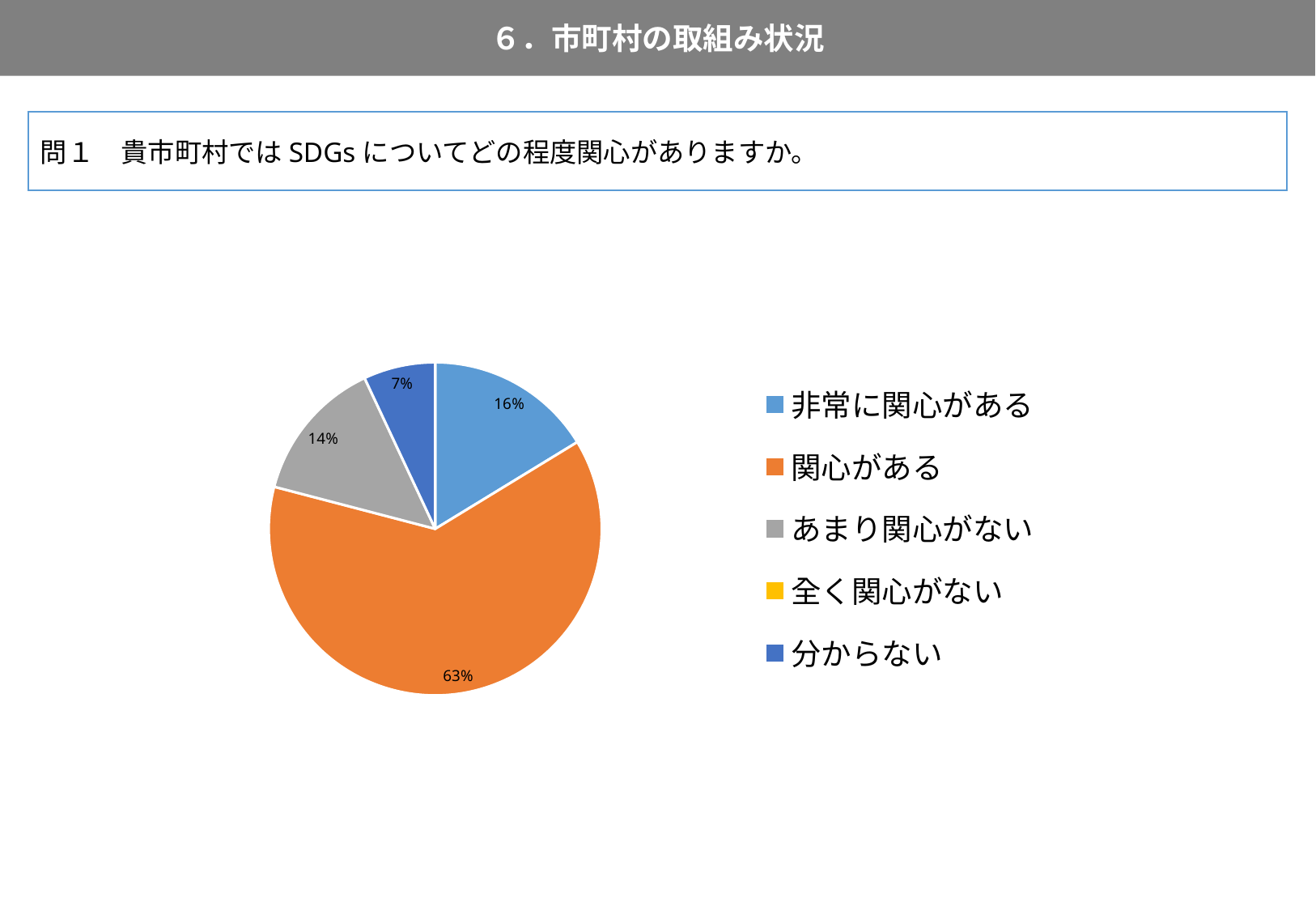
What colour is the slice for 関心がある? orange Which is larger, the share for 非常に関心がある or the share for あまり関心がない? 非常に関心がある What is the difference in percentage points between 関心がある and 非常に関心がある? 47 How many entries does the legend list? 5 Which category has the largest slice of the pie? 関心がある What percentage of the pie is labelled for 非常に関心がある? 16% What kind of chart is shown on the slide? pie chart What percentage of the pie is labelled for 分からない? 7% Among the slices with printed labels, which category has the smallest share? 分からない What percentage of the pie is labelled for 関心がある? 63% What is the combined share of 非常に関心がある and 関心がある? 79% What percentage of the pie is labelled for あまり関心がない? 14%